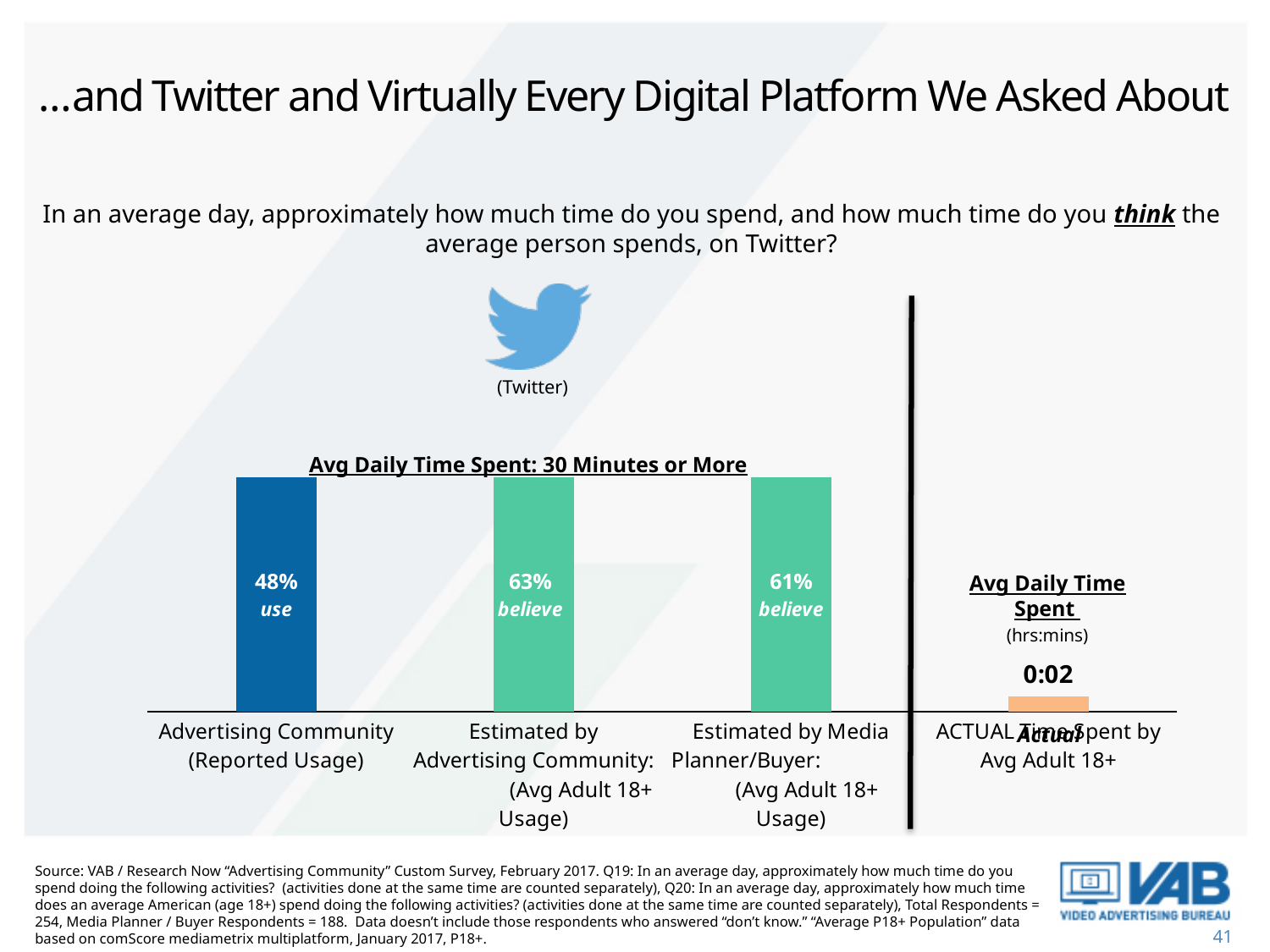
What is the difference in percentage points between the Advertising Community's estimate (63%) and its reported usage (48%)? 15 Which is larger: the Advertising Community's reported usage or the Media Planner/Buyer estimate? Media Planner/Buyer estimate What is the actual average daily time spent on Twitter by the average adult 18+ (hrs:mins)? 0:02 What type of chart is shown on the slide? Bar chart What percentage of the Advertising Community reported using Twitter for 30 minutes or more per day? 48% What is the title printed above the percentage bars? Avg Daily Time Spent: 30 Minutes or More What share of the Advertising Community believes the average adult 18+ spends 30 minutes or more per day on Twitter? 63% What share of Media Planners/Buyers believes the average adult 18+ spends 30 minutes or more per day on Twitter? 61% How many bars are shown in the chart? 4 Which of the three percentage bars is the highest? Estimated by Advertising Community (Avg Adult 18+ Usage) What is the difference in percentage points between the Advertising Community estimate and the Media Planner/Buyer estimate? 2 Which of the three percentage bars is the lowest? Advertising Community (Reported Usage)